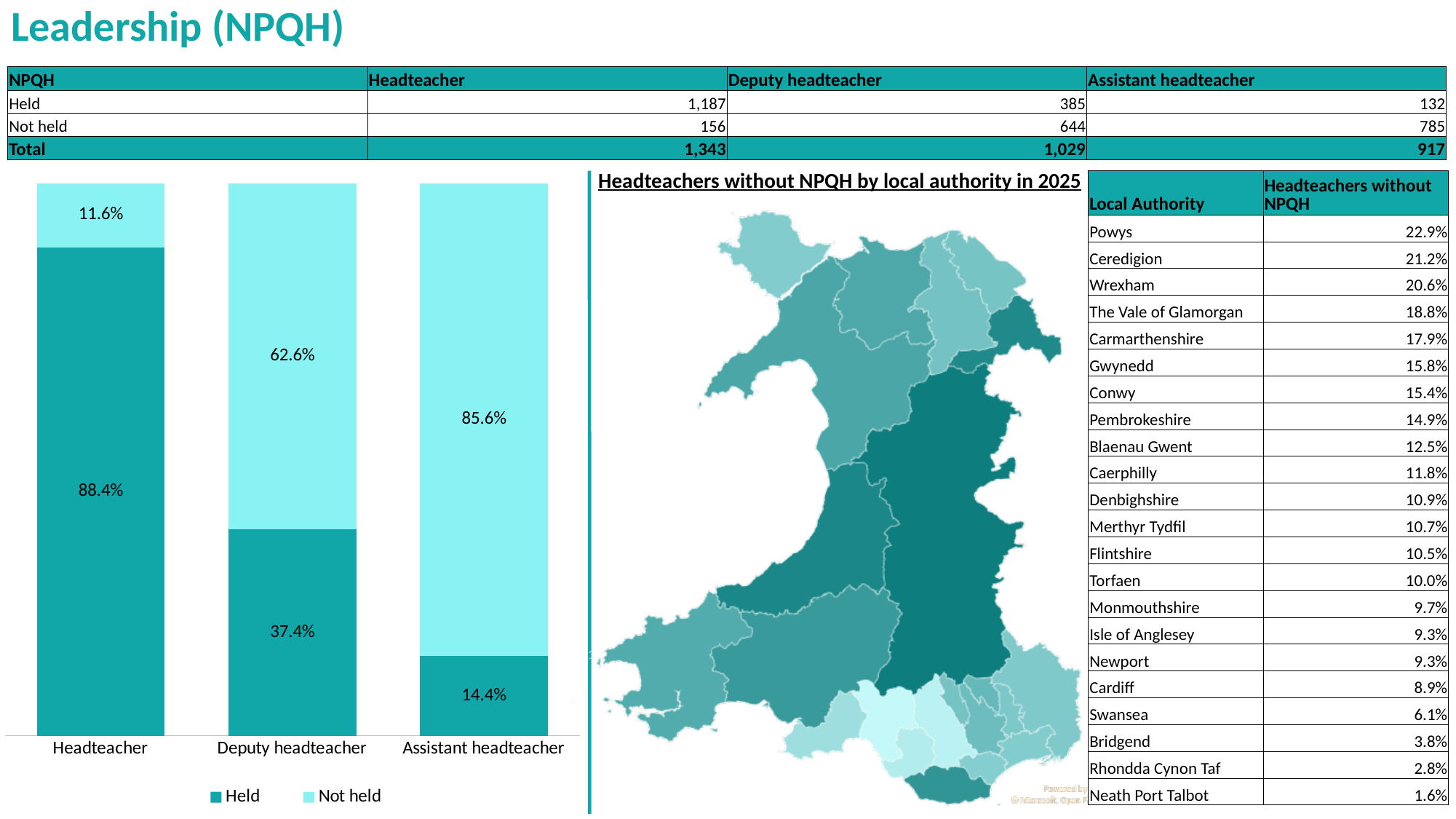
How many categories are shown on the x axis of the stacked bar chart on the left? 3 In the stacked bar chart on the left, is the 'Held' percentage larger for deputy headteachers or assistant headteachers? Deputy headteacher In the stacked bar chart on the left, which category has the highest 'Held' percentage? Headteacher In the stacked bar chart on the left, what is the 'Held' percentage for assistant headteachers? 14.4% In the stacked bar chart on the left, what is the 'Not held' percentage for deputy headteachers? 62.6% What kind of chart is shown on the left of the slide? Stacked bar chart In the stacked bar chart on the left, what is the difference between the 'Not held' percentages for assistant headteachers and deputy headteachers? 23.0% In the stacked bar chart on the left, what is the 'Not held' percentage for headteachers? 11.6% In the stacked bar chart on the left, what percentage of headteachers hold NPQH? 88.4% What is the title of the map chart on the right of the slide? Headteachers without NPQH by local authority in 2025 How many series does the legend of the stacked bar chart on the left list? 2 In the stacked bar chart on the left, which category has the lowest 'Held' percentage? Assistant headteacher